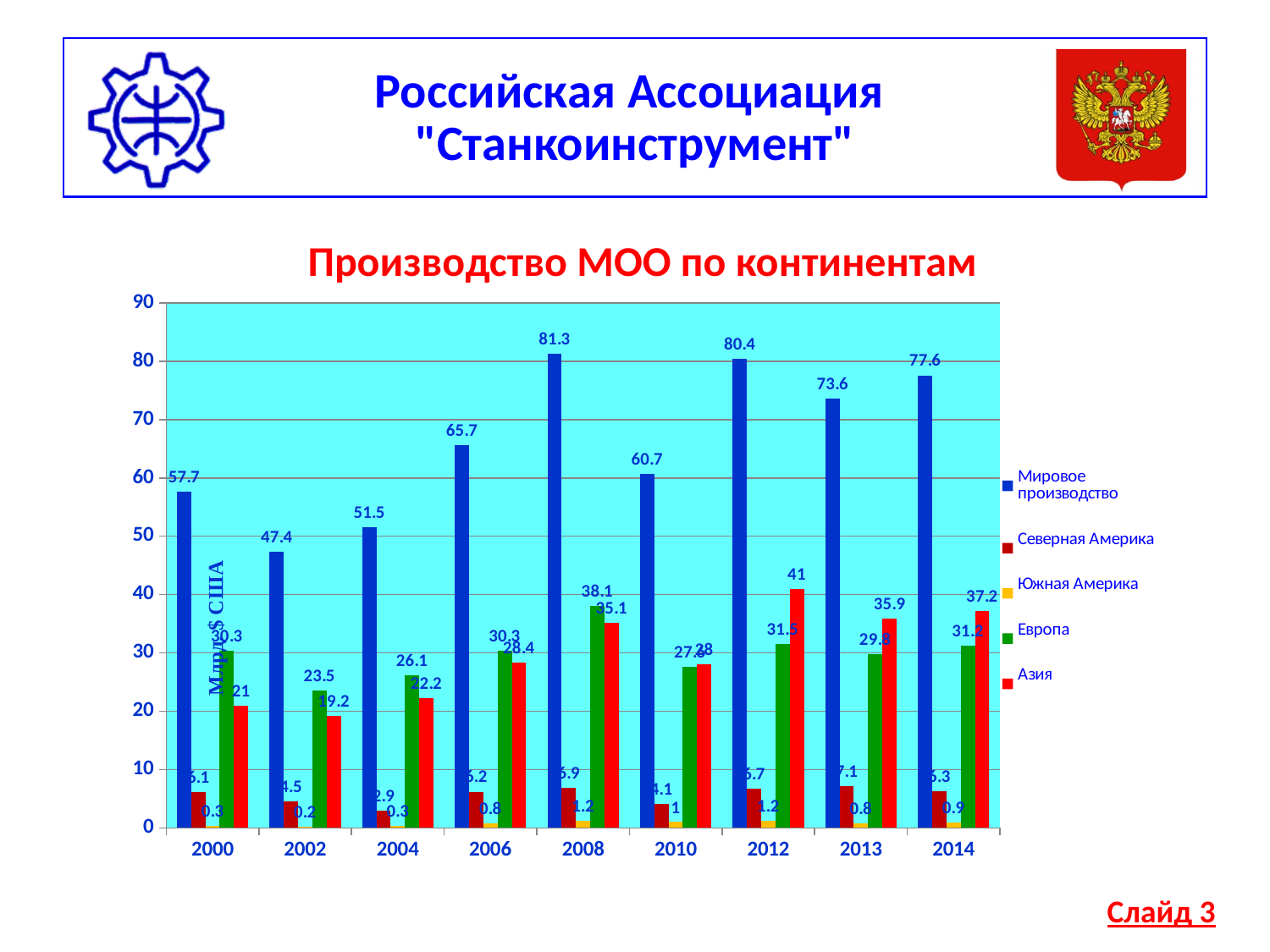
In which year is Мировое производство highest? 2008 How many years are shown on the x axis? 9 In which year is Мировое производство lowest? 2002 In 2000, which is larger: Европа or Азия? Европа What is the difference between Мировое производство in 2014 and in 2013? 4 What kind of chart is shown? bar chart What is the value of Мировое производство in 2008? 81.3 How many series does the legend list? 5 What is the title of the chart? Производство МОО по континентам What is the value for Азия in 2012? 41 In which year is the value for Азия highest? 2012 What is the value for Европа in 2008? 38.1